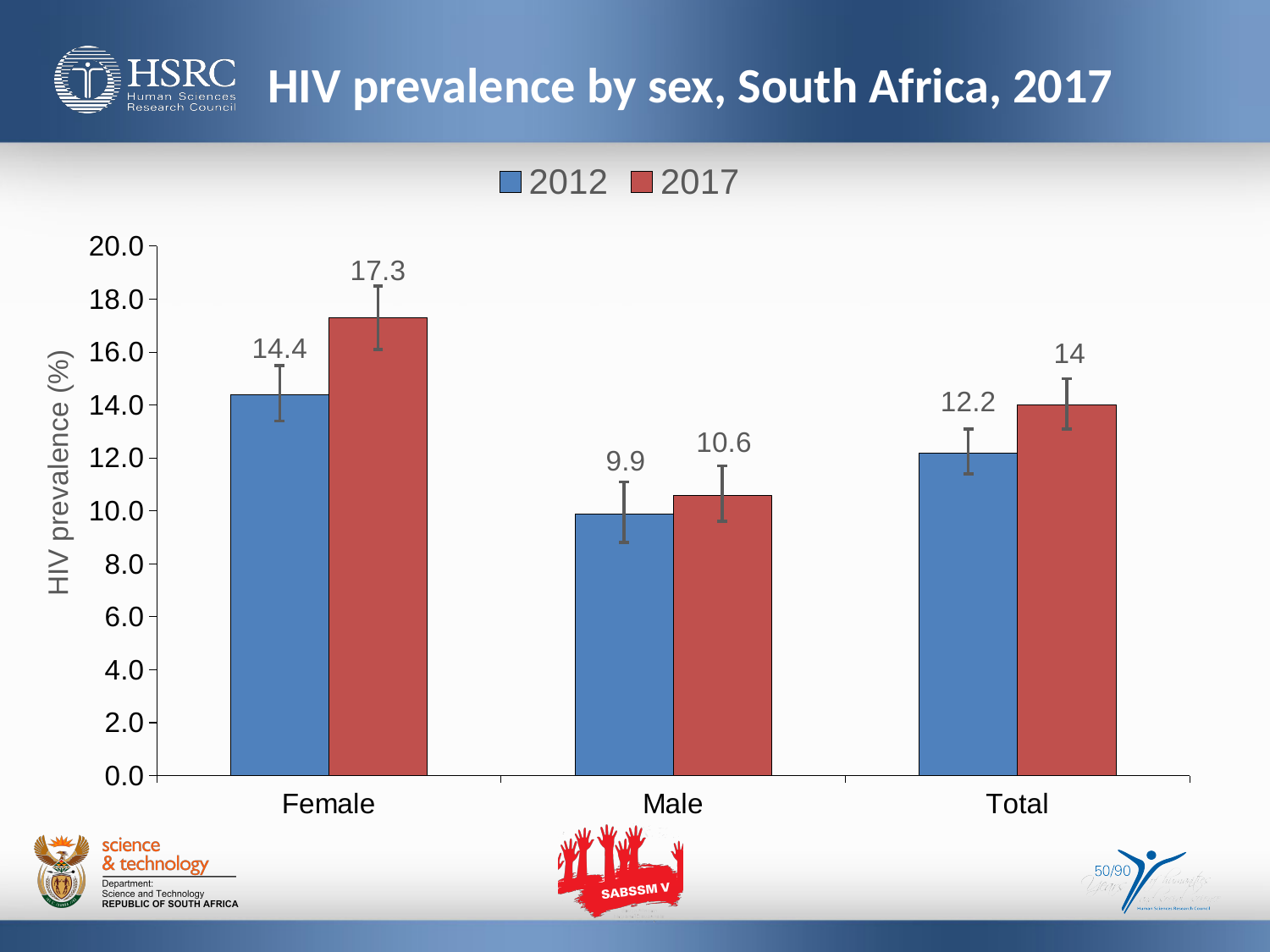
What is the HIV prevalence for Total in 2017? 14 What is the label of the y axis? HIV prevalence (%) Which is larger, the Male 2017 value or the Total 2012 value? Total 2012 Which category has the highest 2017 value? Female What is the difference between the Female and Male values in 2012? 4.5 What is the HIV prevalence for Female in 2017? 17.3 What kind of chart is shown on the slide? Bar chart How many series does the legend list? 2 Which category has the lowest 2012 value? Male How many categories are shown on the x axis? 3 What is the difference between the Female 2017 and Female 2012 values? 2.9 What is the HIV prevalence for Male in 2012? 9.9